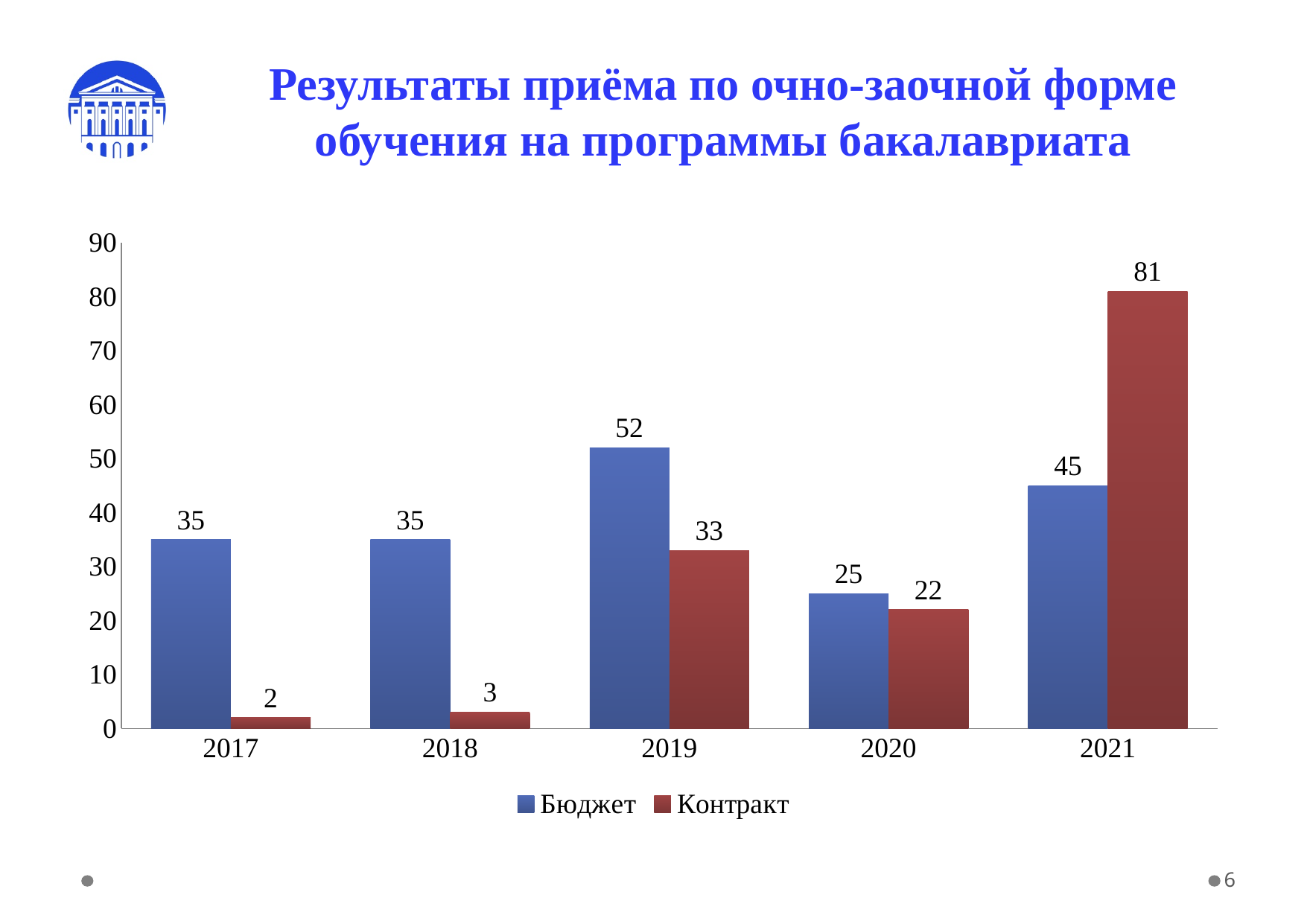
Is the value for Бюджет in 2021 greater or less than 40? greater What is the value for Контракт in 2017? 2 What is the value for Бюджет in 2019? 52 In which year is the Контракт value highest? 2021 How many series does the legend list? 2 What kind of chart is shown on the slide? bar chart What is the value for Контракт in 2021? 81 In which year is the Бюджет value lowest? 2020 What colour are the Контракт bars? red How many years are shown on the x axis? 5 What is the difference between the Контракт and Бюджет values in 2021? 36 Which is larger in 2020, Бюджет or Контракт? Бюджет